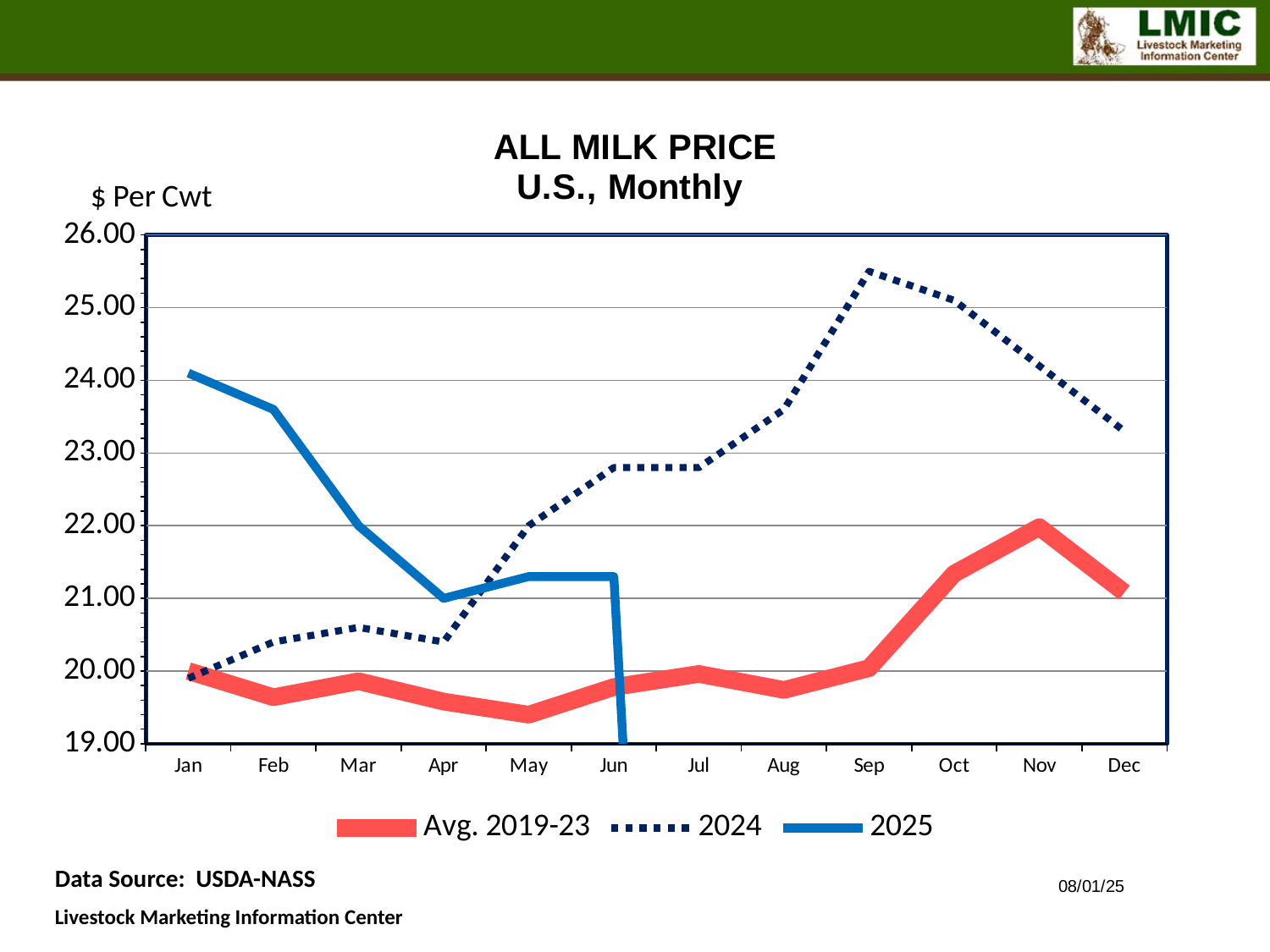
Which series has the higher value in Jan, 2024 or 2025? 2025 How many months are shown along the x axis? 12 Is the Avg. 2019-23 value for May greater or less than 20.00? less What is the label on the y axis of the chart? $ Per Cwt In which month is the Avg. 2019-23 series at its highest? Nov In which month is the Avg. 2019-23 series at its lowest? May Is the 2024 value for Sep greater or less than 25.00? greater How many series does the legend list? 3 Is the 2025 value for Feb greater or less than 23.00? greater Does the 2025 series rise or fall from Jan to Apr? Fall What kind of chart is shown on the slide? Line chart In which month does the 2024 series reach its highest value? Sep